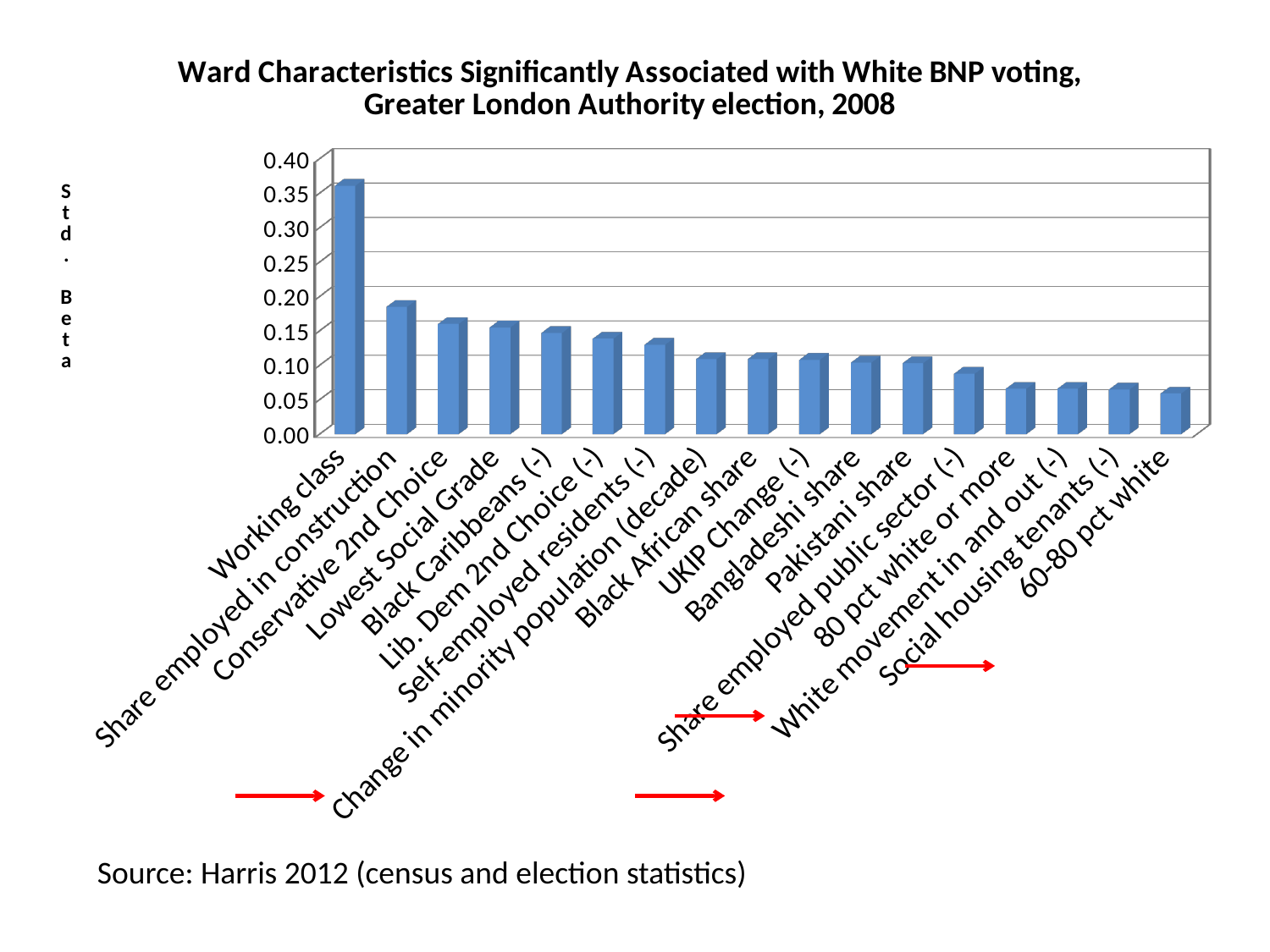
How many ward characteristics (bars) are plotted in the chart? 17 Which has the larger value, Conservative 2nd Choice or Social housing tenants (-)? Conservative 2nd Choice Do the bar values rise or fall moving from left to right along the x axis? Fall Which has the larger value, Working class or Share employed in construction? Working class Which ward characteristic has the highest standardised beta? Working class Is the value for Conservative 2nd Choice greater or less than 0.10? greater What kind of chart is shown on the slide? Bar chart Is the value for Working class greater or less than 0.30? greater Is the value for Black Caribbeans (-) greater or less than 0.10? greater What is the label on the vertical axis of the chart? Std. Beta